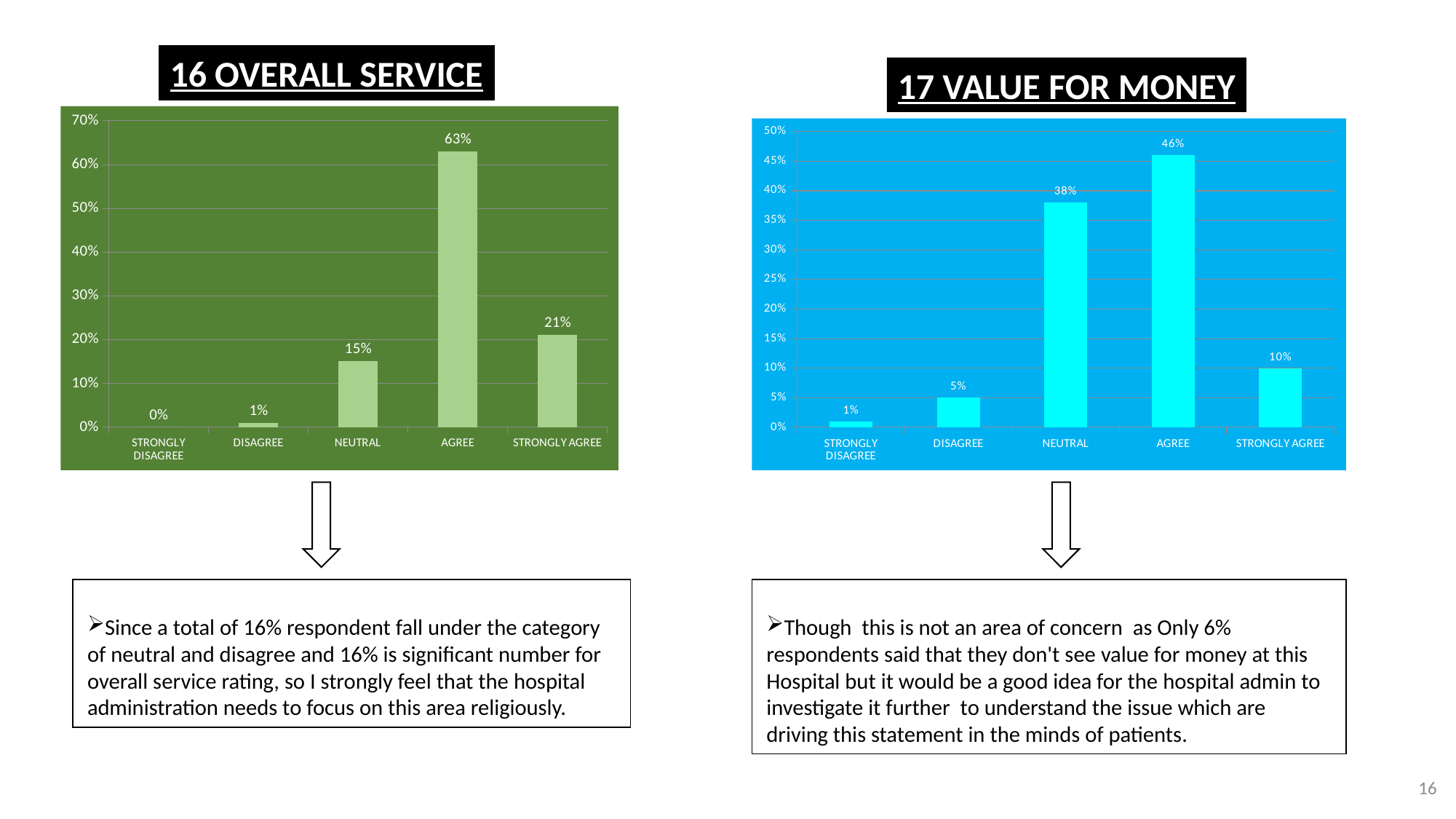
In the '16 OVERALL SERVICE' chart, what is the value for STRONGLY AGREE? 21% In the '17 VALUE FOR MONEY' chart, what is the difference between the values for AGREE and NEUTRAL? 8% In the '16 OVERALL SERVICE' chart, what is the difference between the values for AGREE and STRONGLY AGREE? 42% In the '17 VALUE FOR MONEY' chart, which is larger, the value for NEUTRAL or the value for STRONGLY AGREE? NEUTRAL In the '16 OVERALL SERVICE' chart, which category has the highest value? AGREE In the '17 VALUE FOR MONEY' chart, which category has the highest value? AGREE In the '17 VALUE FOR MONEY' chart, what is the value for NEUTRAL? 38% In the '16 OVERALL SERVICE' chart, how many categories are shown on the x axis? 5 In the '17 VALUE FOR MONEY' chart, what is the value for DISAGREE? 5% In the '16 OVERALL SERVICE' chart, which category has the lowest value? STRONGLY DISAGREE What kind of chart is the '17 VALUE FOR MONEY' chart? Bar chart In the '16 OVERALL SERVICE' chart, what is the value for AGREE? 63%